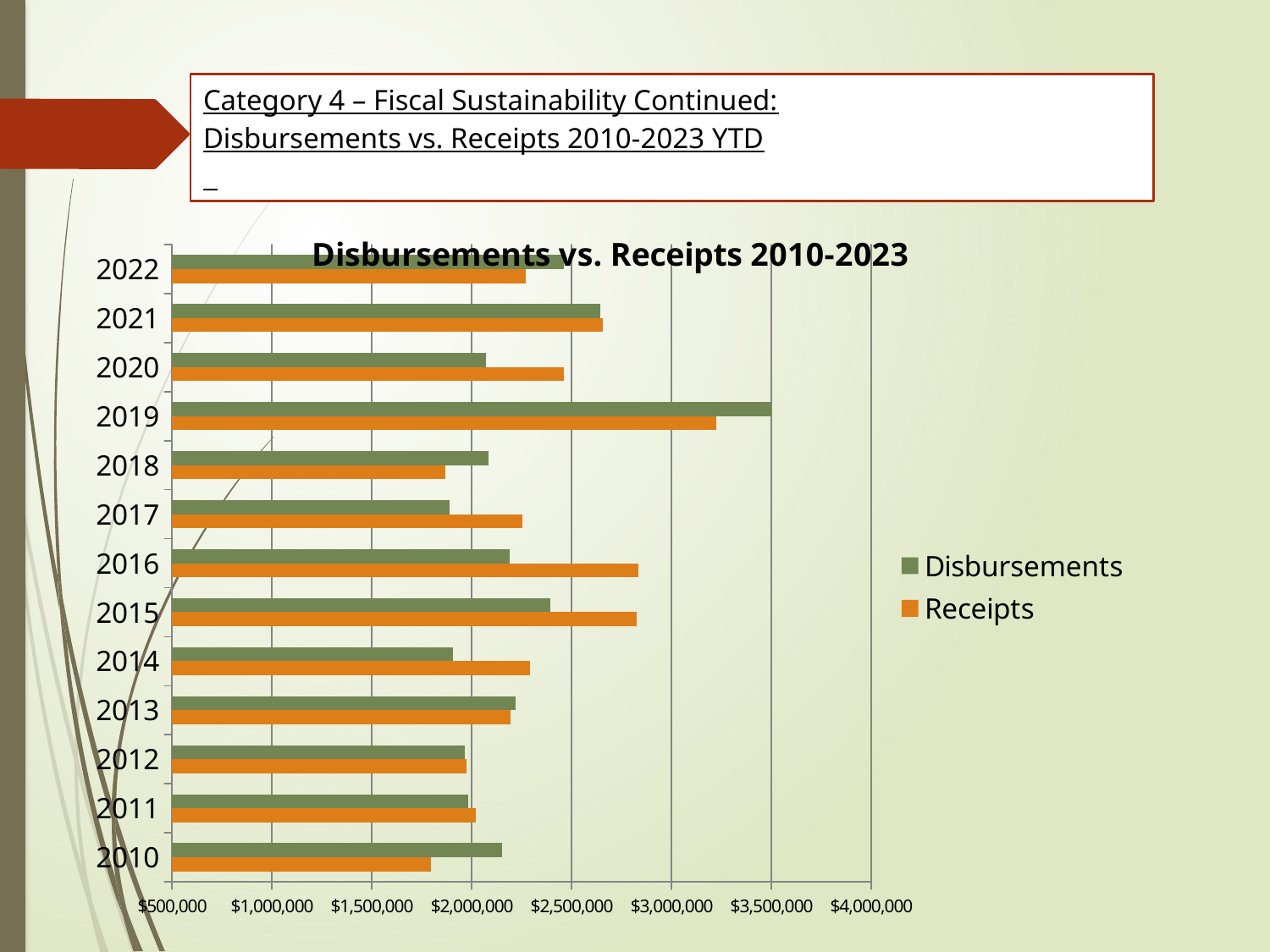
Which year has the highest Disbursements value? 2019 Which year has the highest Receipts value? 2019 Which colour represents the Receipts series in the chart? Orange In 2016, which is larger, Disbursements or Receipts? Receipts How many years are plotted on the chart? 13 What kind of chart is shown on the slide? Bar chart How many series does the chart legend list? 2 Is the Receipts value for 2010 greater or less than $2,000,000? less What is the title of the chart? Disbursements vs. Receipts 2010-2023 Is the Receipts value for 2016 greater or less than $2,500,000? greater Is the Disbursements value for 2019 greater or less than $3,000,000? greater In 2010, which is larger, Disbursements or Receipts? Disbursements